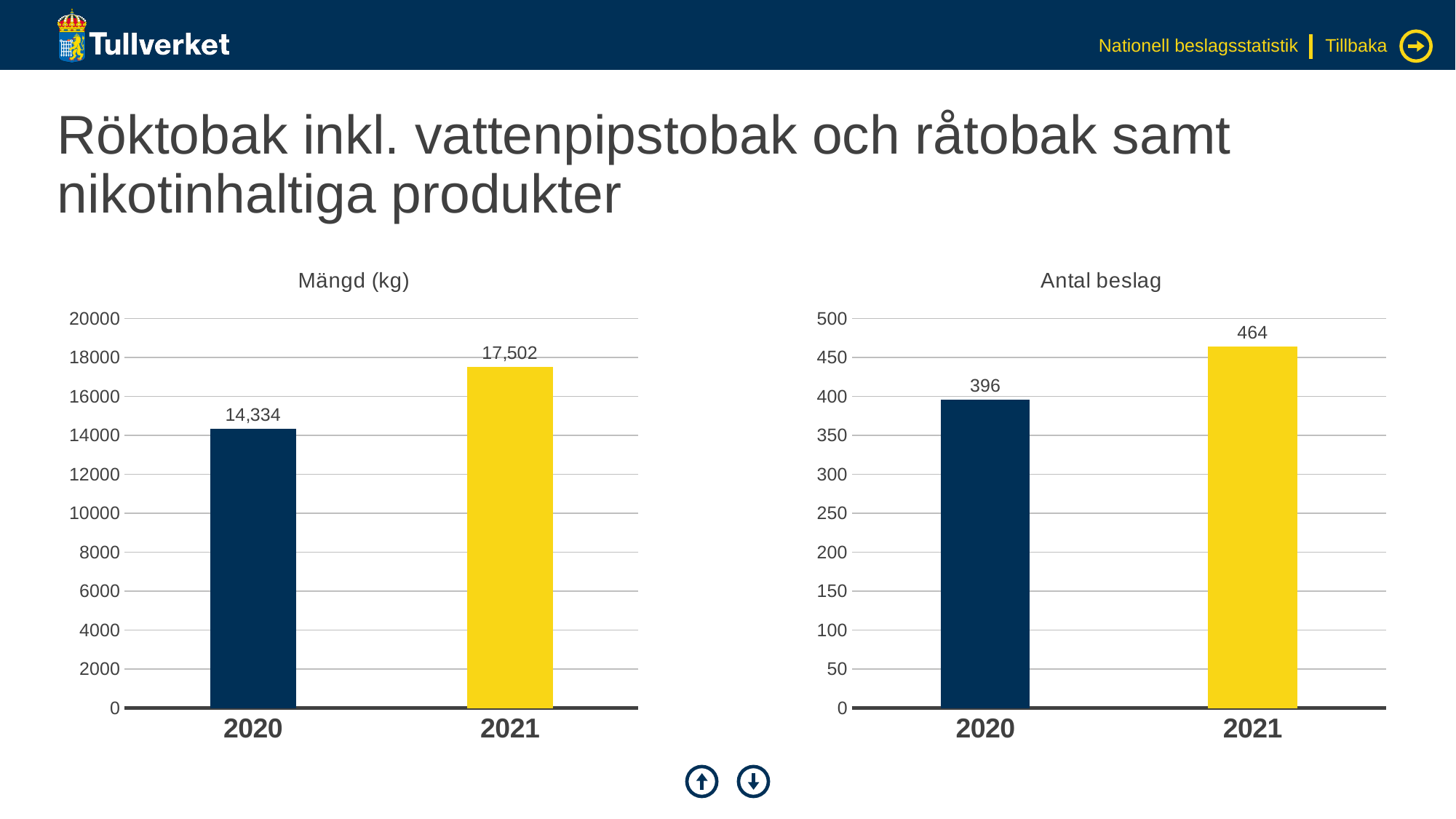
In the 'Mängd (kg)' chart, what is the value for 2020? 14,334 What kind of chart is the 'Antal beslag' chart? Bar chart In the 'Mängd (kg)' chart, what is the difference between the 2021 and 2020 values? 3,168 In the 'Antal beslag' chart, what is the value for 2021? 464 In the 'Mängd (kg)' chart, do the values rise or fall from 2020 to 2021? Rise In the 'Mängd (kg)' chart, which year has the higher value? 2021 In the 'Mängd (kg)' chart, what is the value for 2021? 17,502 In the 'Antal beslag' chart, what is the value for 2020? 396 In the 'Antal beslag' chart, what is the difference between the 2021 and 2020 values? 68 In the 'Antal beslag' chart, which year has the lower value? 2020 How many categories are shown on the x axis of the 'Mängd (kg)' chart? 2 In the 'Antal beslag' chart, is the value for 2020 greater or less than 400? less